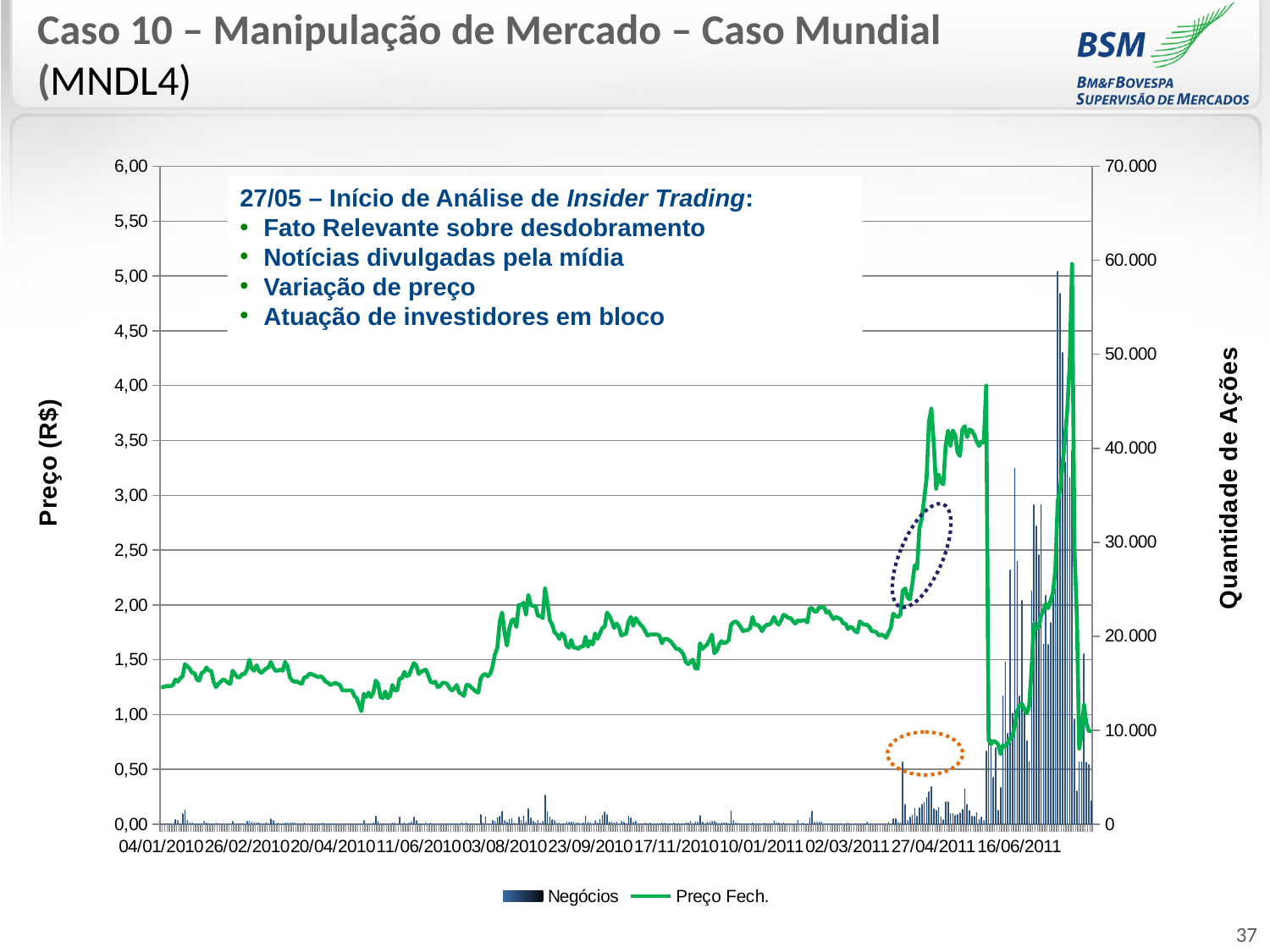
What are the two series named in the legend? Negócios and Preço Fech. What is the highest value shown on the right vertical axis? 70.000 What is the first date label on the x axis? 04/01/2010 What is the title of the left vertical axis? Preço (R$) What is the highest value shown on the left vertical axis? 6,00 Is the highest Preço Fech. value on the chart greater or less than 3,50? greater Is the tallest Negócios bar greater or less than 50.000? greater What is the last date label on the x axis? 16/06/2011 How many date labels are shown on the x axis? 11 Is the Preço Fech. value at 04/01/2010 greater or less than 1,50? less What kind of chart is shown on the slide? A combination bar and line chart How many series does the legend list? 2